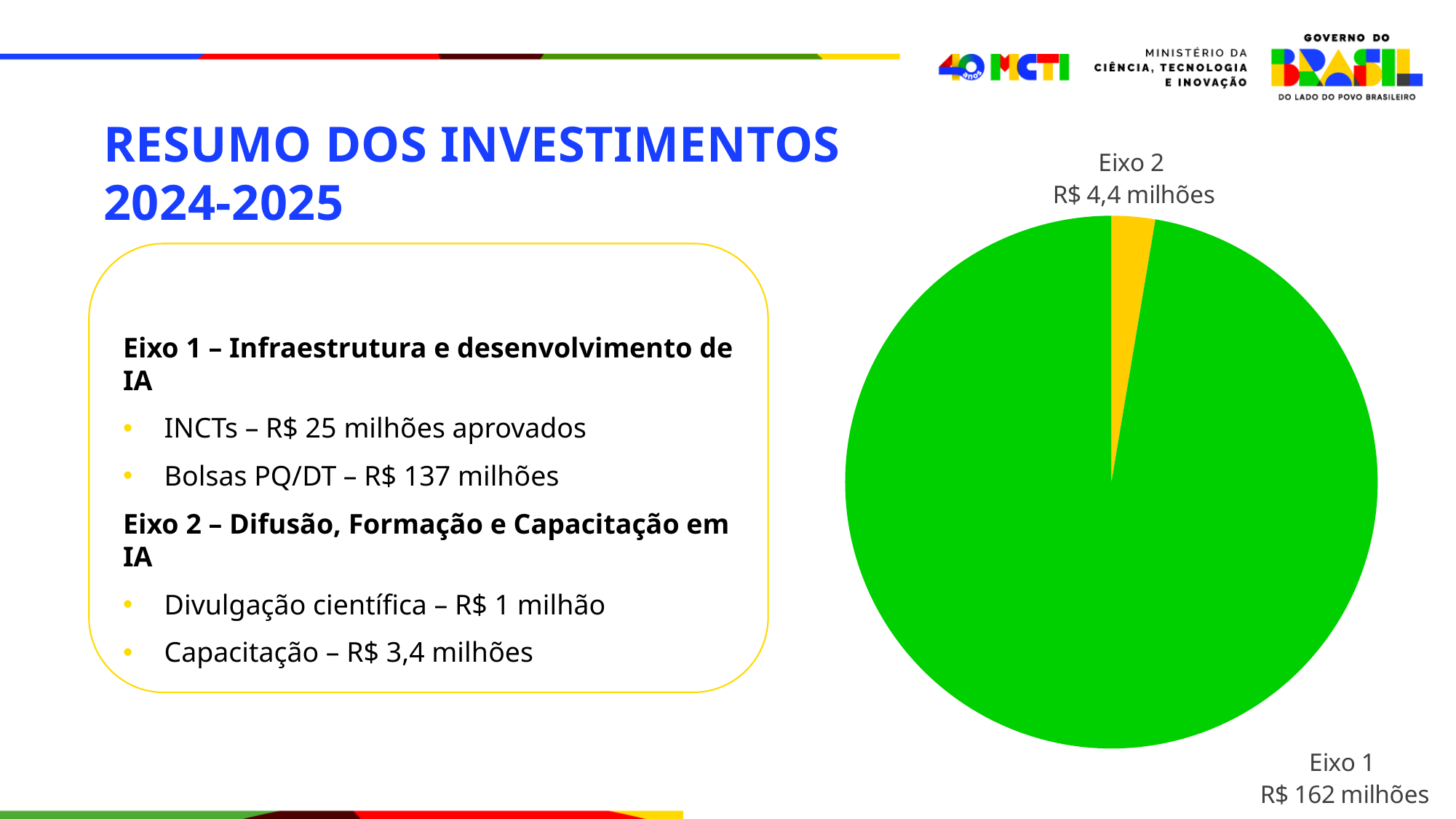
Which slice of the pie chart is the largest? Eixo 1 How many slices does the pie chart have? 2 What is the value shown for Eixo 1 in the pie chart? R$ 162 milhões What is the difference between the values for Eixo 1 and Eixo 2 in the pie chart? R$ 157,6 milhões Which slice of the pie chart is the smallest? Eixo 2 What colour is the Eixo 1 slice in the pie chart? green What kind of chart is shown on the slide? pie chart What is the value shown for Eixo 2 in the pie chart? R$ 4,4 milhões Which is larger in the pie chart, Eixo 1 or Eixo 2? Eixo 1 What is the combined total of the two slices in the pie chart? R$ 166,4 milhões What colour is the Eixo 2 slice in the pie chart? yellow